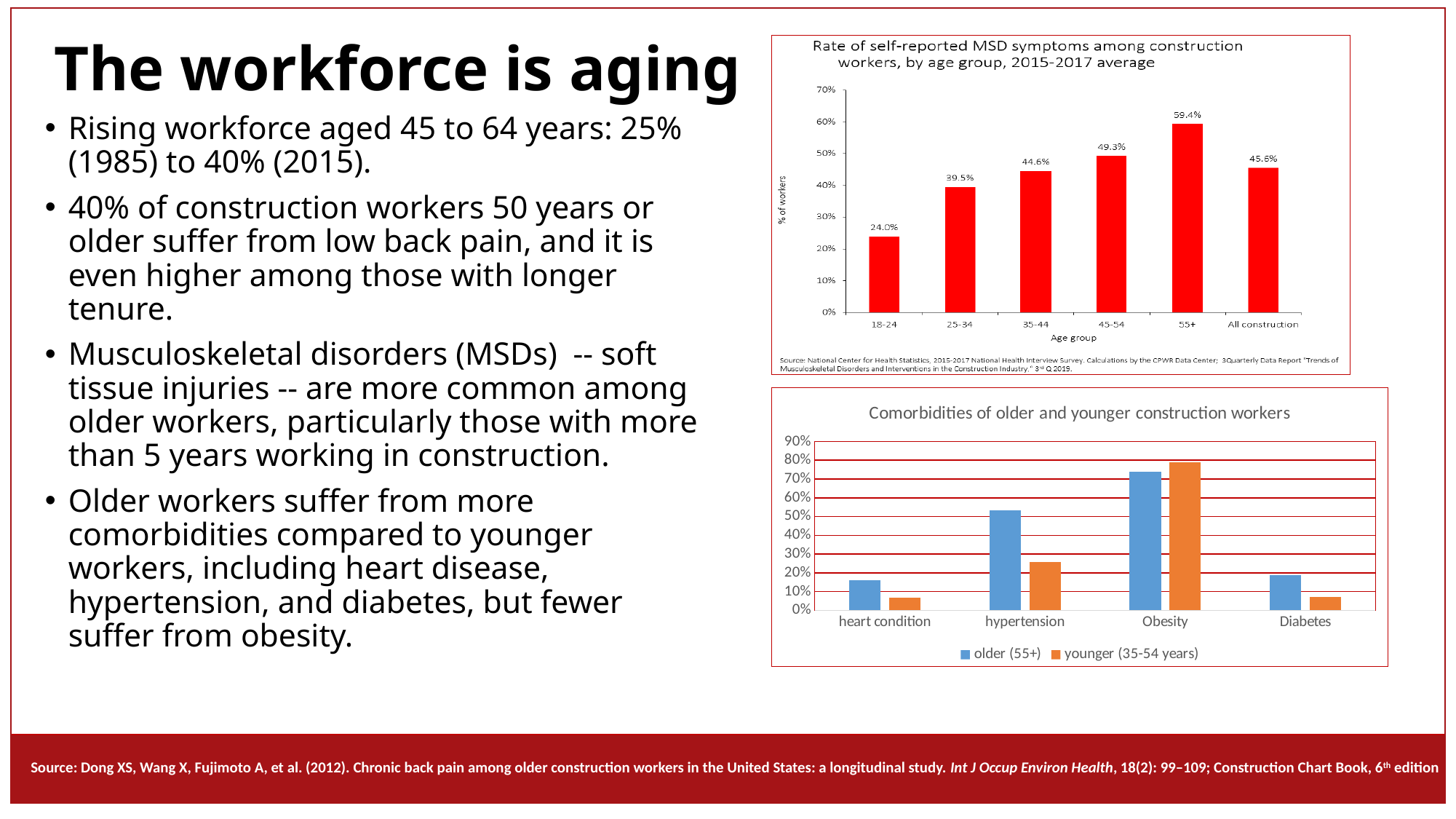
In the top chart on MSD symptoms by age group, which age group has the lowest rate? 18-24 In the top chart on MSD symptoms by age group, what is the rate for the 55+ age group? 59.4% In the bottom chart on comorbidities, how many series does the legend list? 2 In the bottom chart on comorbidities, which group has the larger value for hypertension, older (55+) or younger (35-54 years)? older (55+) What kind of chart is the bottom chart on comorbidities? bar chart In the top chart on MSD symptoms by age group, how many bars are plotted? 6 In the top chart on MSD symptoms by age group, what is the rate for All construction? 45.6% In the top chart on MSD symptoms by age group, what is the difference between the 55+ rate and the 18-24 rate? 35.4% In the top chart on MSD symptoms by age group, do the rates rise or fall from the 18-24 group to the 55+ group? rise In the top chart on MSD symptoms by age group, which age group has the highest rate? 55+ In the top chart on MSD symptoms by age group, what is the rate for the 18-24 age group? 24.0% In the bottom chart on comorbidities, is the value for Obesity among older (55+) workers greater or less than 60%? greater